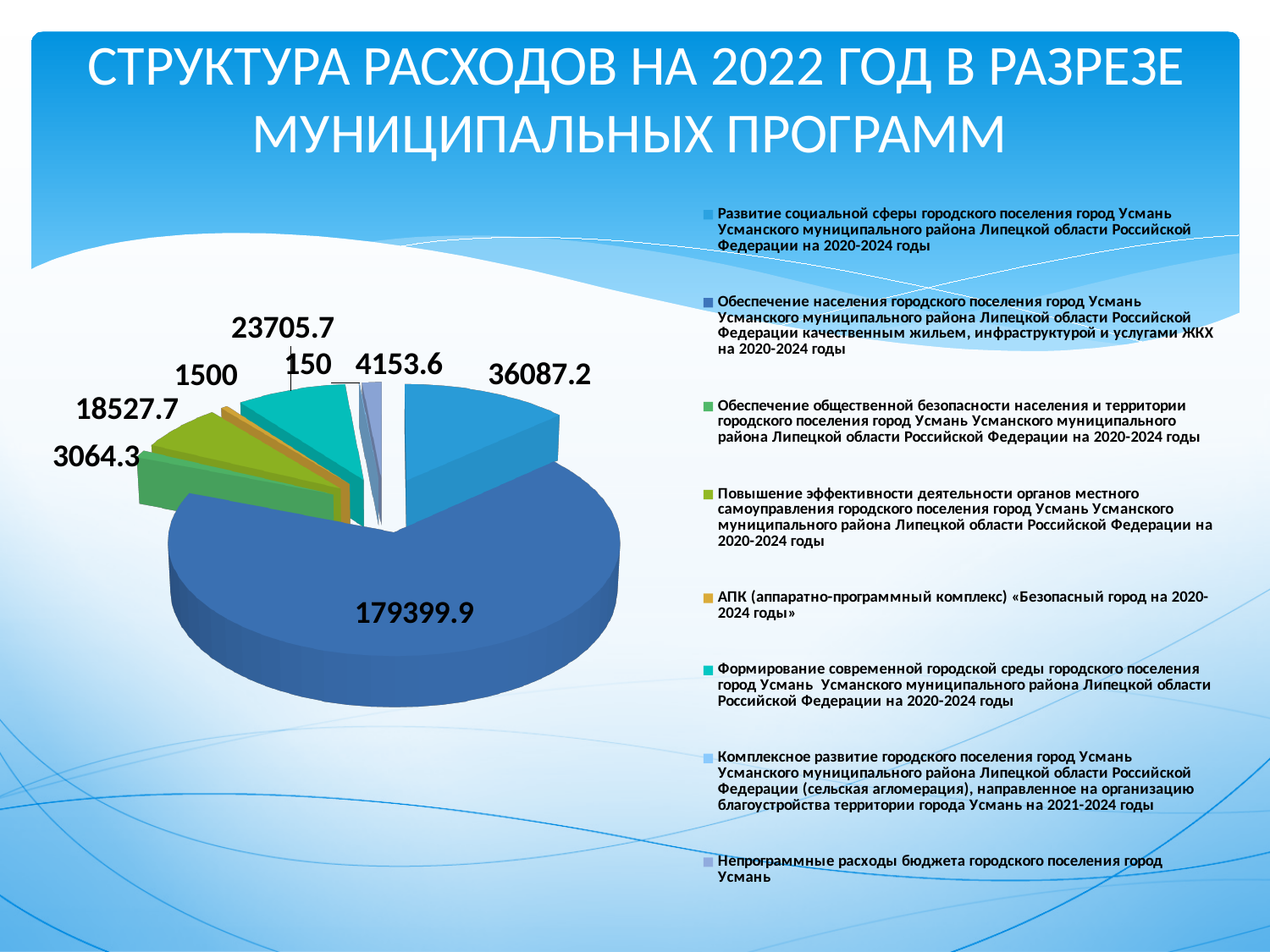
What is the value for «АПК (аппаратно-программный комплекс) «Безопасный город на 2020-2024 годы»»? 1500 What is the value for «Непрограммные расходы бюджета городского поселения город Усмань»? 4153.6 What is the value for «Развитие социальной сферы городского поселения город Усмань ... на 2020-2024 годы»? 36087.2 Which is larger: the slice for «Повышение эффективности деятельности органов местного самоуправления...» (18527.7) or the slice for «Обеспечение общественной безопасности...» (3064.3)? Повышение эффективности деятельности органов местного самоуправления (18527.7) What is the value of the smallest slice of the pie chart? 150 How many slices does the pie chart have? 8 Which legend entry corresponds to the largest slice (179399.9)? Обеспечение населения городского поселения город Усмань ... качественным жильем, инфраструктурой и услугами ЖКХ на 2020-2024 годы How many entries does the legend list? 8 What type of chart is shown on the slide? Pie chart What is the value of the largest slice of the pie chart? 179399.9 What is the value for «Формирование современной городской среды городского поселения город Усмань ... на 2020-2024 годы»? 23705.7 What is the difference between the slice labelled 36087.2 and the slice labelled 23705.7? 12381.5